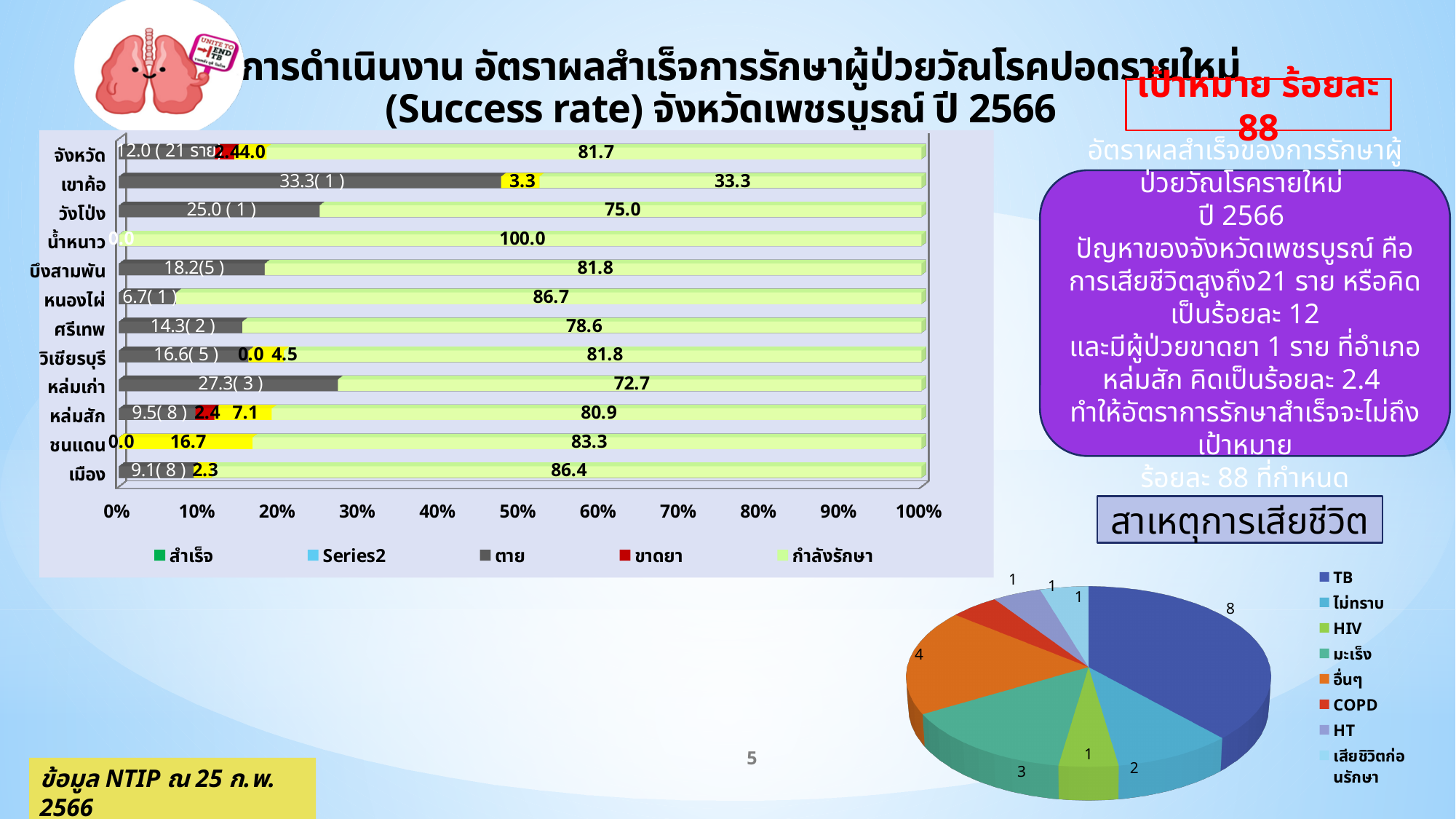
How many categories are shown on the vertical axis of the bar chart on the left? 12 In the bar chart on the left, what is the ตาย value shown for เขาค้อ? 33.3( 1 ) In the bar chart on the left, which has a larger กำลังรักษา value, ชนแดน or ศรีเทพ? ชนแดน In the pie chart titled สาเหตุการเสียชีวิต, which cause has the largest slice? TB What type of chart is the chart titled สาเหตุการเสียชีวิต? pie chart In the bar chart on the left, which category has the highest กำลังรักษา value? น้ำหนาว In the pie chart titled สาเหตุการเสียชีวิต, what is the value for TB? 8 In the bar chart on the left, what is the กำลังรักษา value for น้ำหนาว? 100.0 In the bar chart on the left, what is the กำลังรักษา value for หล่มเก่า? 72.7 In the bar chart on the left, what is the difference between the กำลังรักษา values of หนองไผ่ and วังโป่ง? 11.7 How many series does the legend of the bar chart on the left list? 5 In the bar chart on the left, which district has the lowest กำลังรักษา value? เขาค้อ